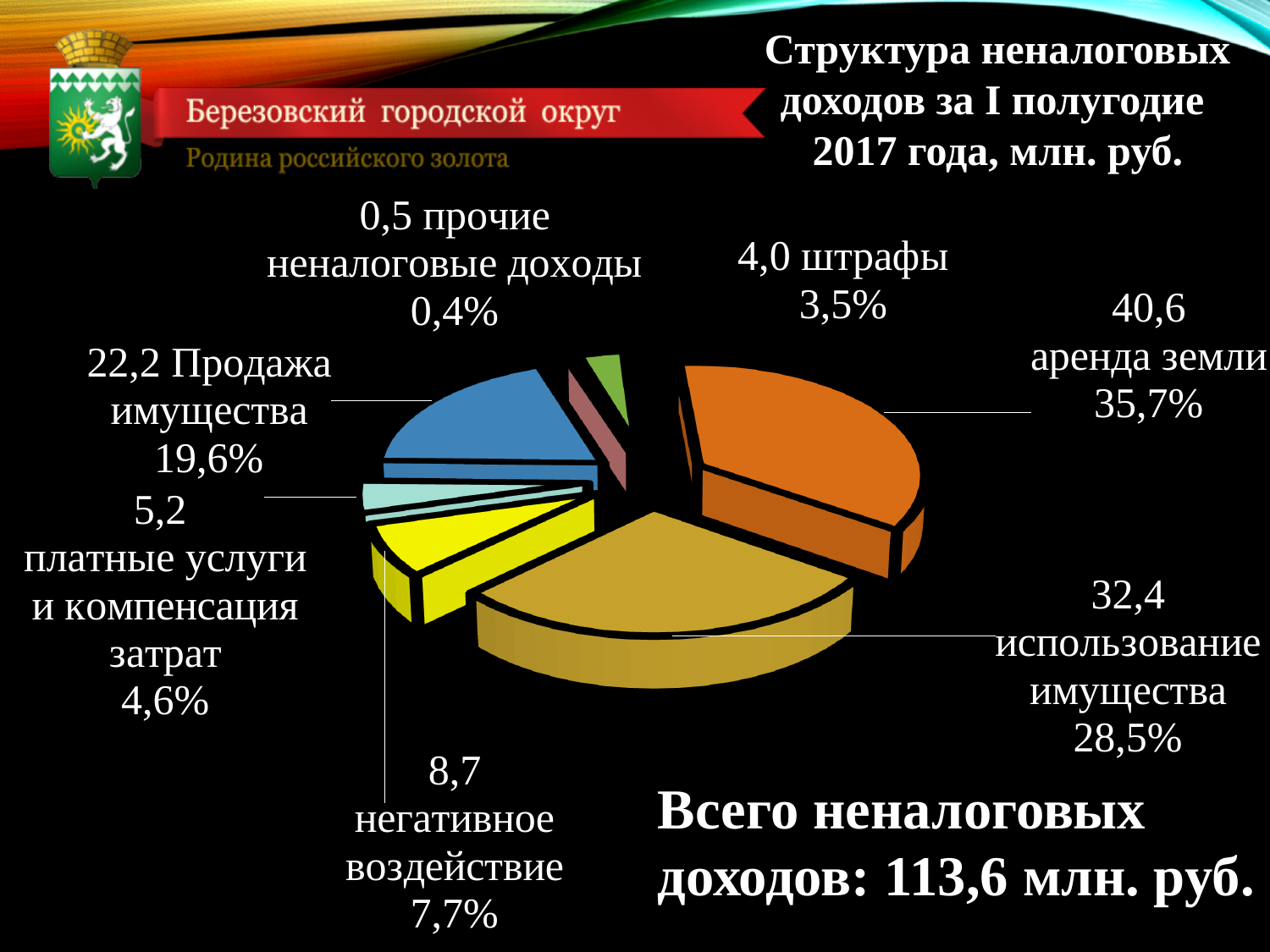
What kind of chart is shown on the slide? pie chart What is the difference between the values for аренда земли and использование имущества? 8,2 What is the value for аренда земли in the pie chart? 40,6 What is the total of all non-tax revenues stated on the slide? 113,6 млн. руб. Which category has the largest slice of the pie? аренда земли What share of the pie does использование имущества represent? 28,5% What is the value for штрафы? 4,0 What is the title of the chart? Структура неналоговых доходов за I полугодие 2017 года, млн. руб. Which is larger: Продажа имущества or негативное воздействие? Продажа имущества How many slices does the pie chart have? 7 Which category has the smallest slice of the pie? прочие неналоговые доходы What share of the pie does негативное воздействие represent? 7,7%